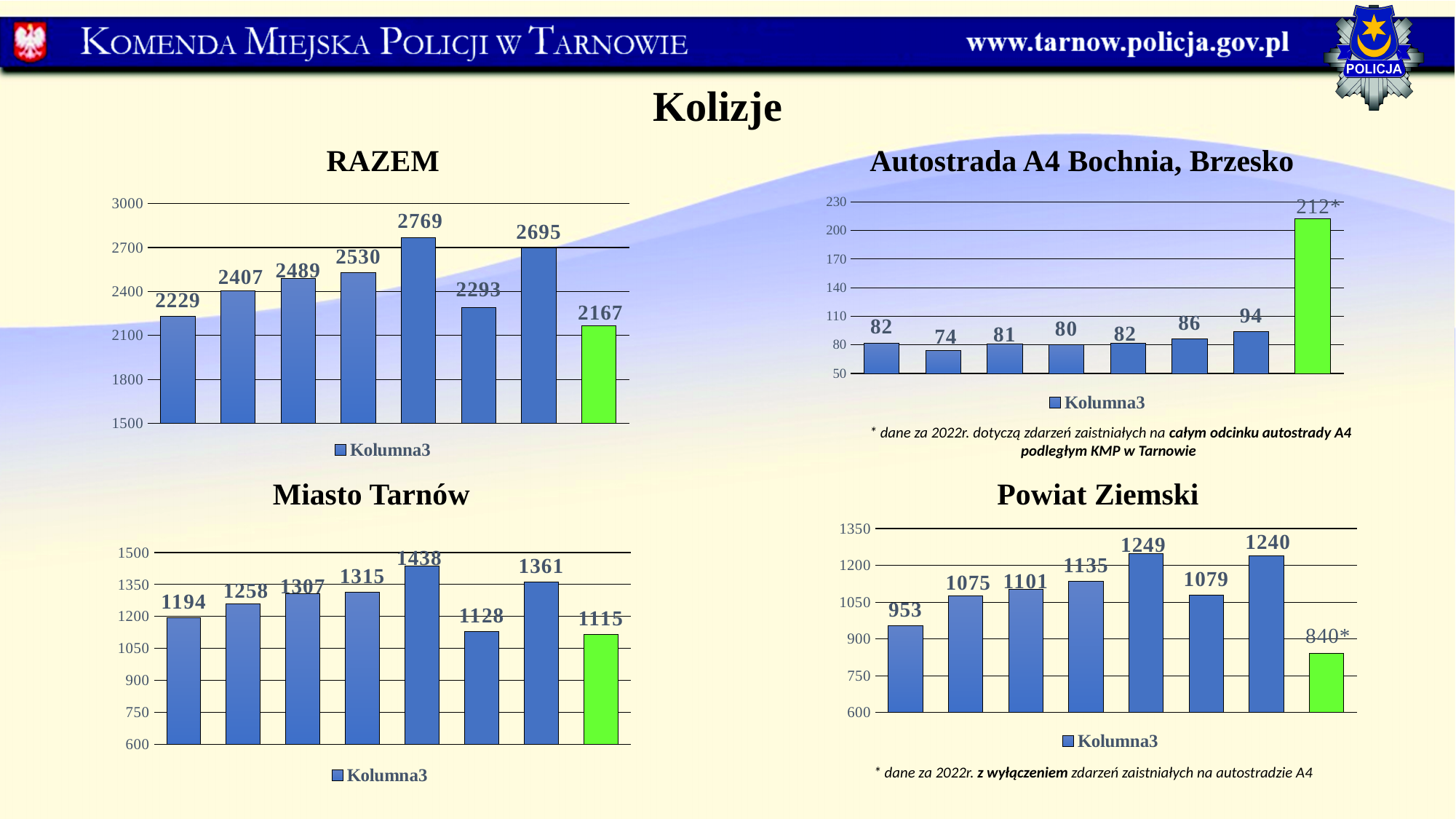
In the RAZEM chart, what is the difference between the second bar and the first bar? 178 In the Autostrada A4 Bochnia, Brzesko chart, what is the lowest value shown? 74 How many bars are plotted in the RAZEM chart? 8 In the RAZEM chart, what is the highest value shown? 2769 What legend entry is shown under the RAZEM chart? Kolumna3 In the Miasto Tarnów chart, what is the difference between the highest bar and the green (last) bar? 323 What kind of chart is the Miasto Tarnów chart? bar chart How many series does the legend of the Powiat Ziemski chart list? 1 In the Powiat Ziemski chart, what is the value of the first bar? 953 In the RAZEM chart, what is the value of the green (last) bar? 2167 In the Autostrada A4 Bochnia, Brzesko chart, what is the value of the green (last) bar? 212* In the Powiat Ziemski chart, which is larger: the fourth bar or the fifth bar? the fifth bar (1249)